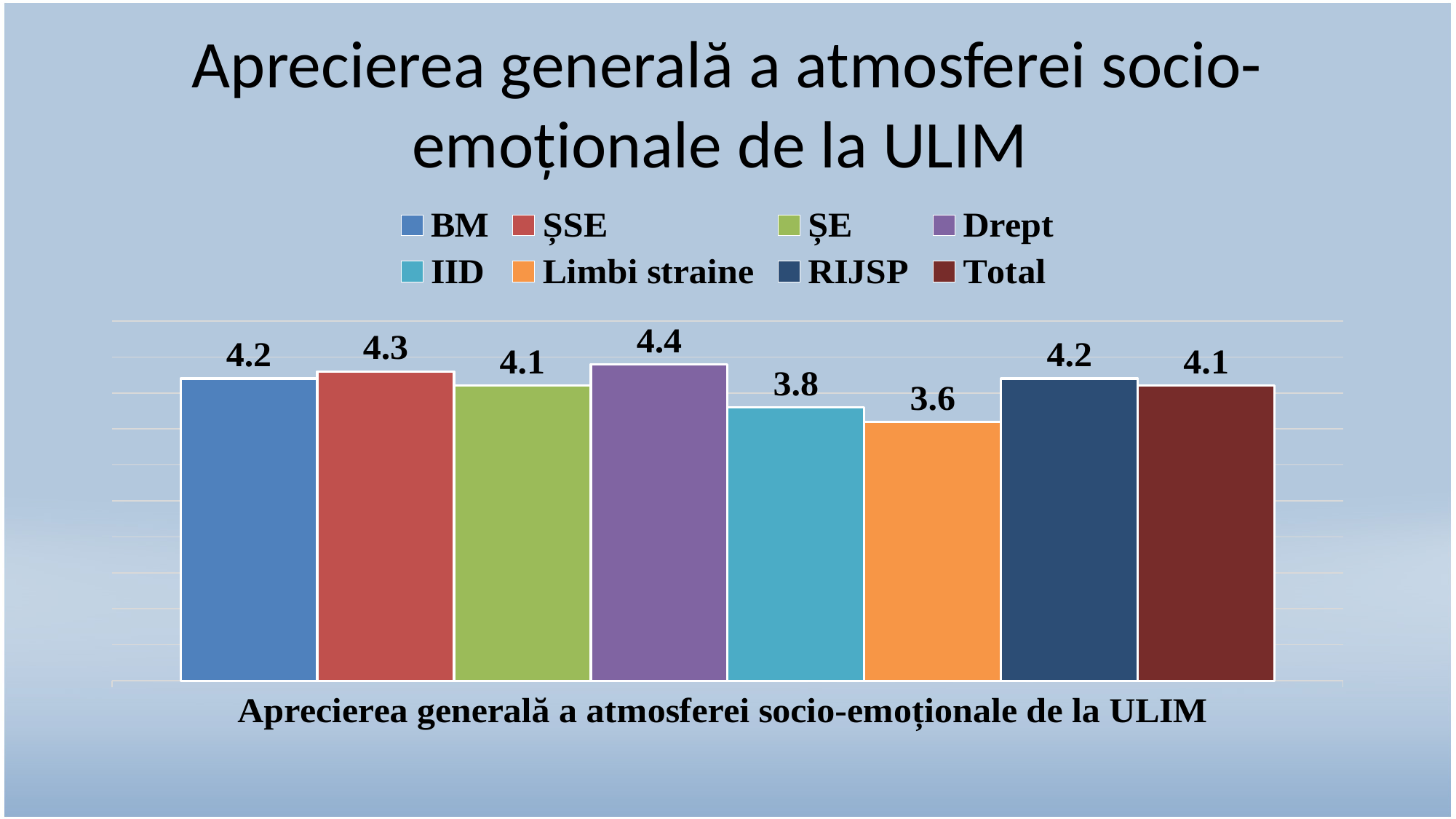
What is the difference between the values for Drept and Limbi straine? 0.8 Which series has the lowest value? Limbi straine Which series has the highest value? Drept What is the difference between the values for ȘSE and ȘE? 0.2 What kind of chart is shown on the slide? Bar chart What colour is the bar for Limbi straine? Orange What is the value for IID? 3.8 Which is larger, the value for ȘSE or the value for IID? ȘSE How many series does the legend list? 8 What is the value for Total? 4.1 What is the value for Limbi straine? 3.6 What is the value for Drept? 4.4